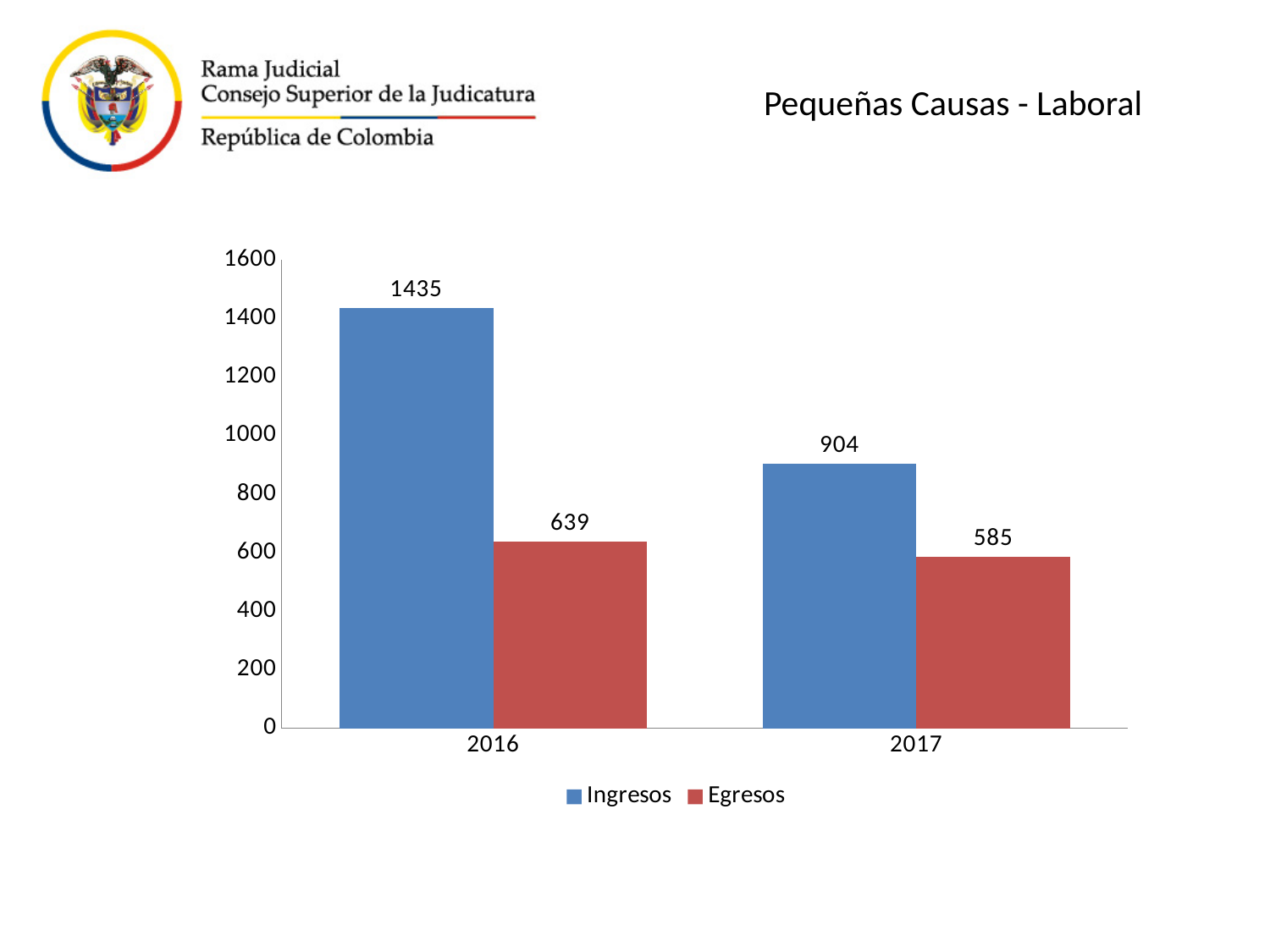
Which is larger: Ingresos in 2017 or Egresos in 2016? Ingresos in 2017 How many series does the legend list? 2 What is the value of Ingresos for 2016? 1435 Is the value for Ingresos in 2017 greater or less than 1000? less What is the value of Egresos for 2017? 585 Which year has the lowest Egresos value? 2017 What is the difference between Ingresos and Egresos in 2016? 796 What is the difference between Ingresos in 2016 and Ingresos in 2017? 531 What kind of chart is shown on the slide? bar chart What is the value of Egresos for 2016? 639 Which year has the highest Ingresos value? 2016 How many years are shown on the x axis? 2